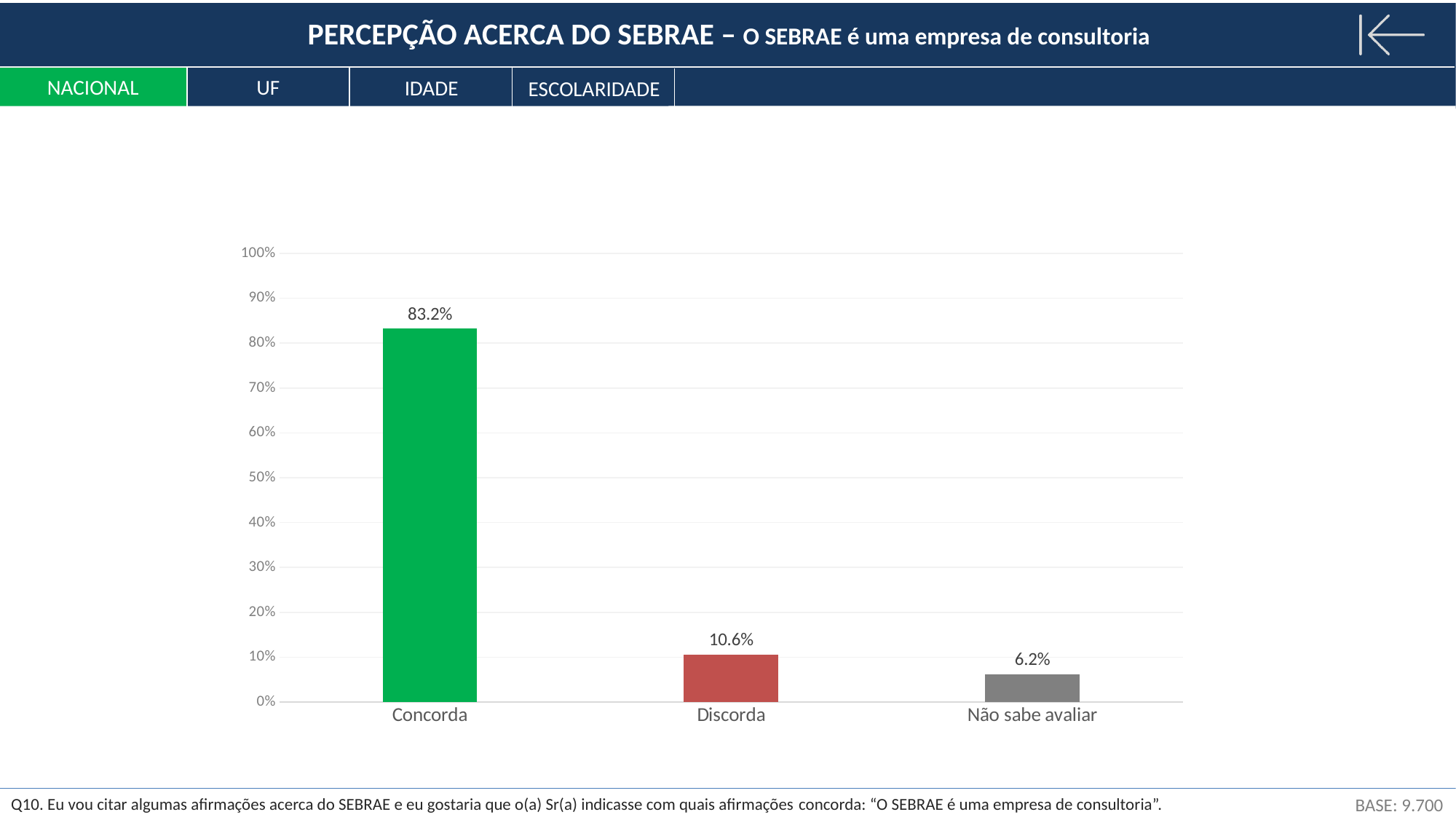
Which is larger, the value for Discorda or the value for Não sabe avaliar? Discorda Is the value for Concorda greater or less than 80%? greater What is the value for Não sabe avaliar? 6.2% What is the difference between the values for Concorda and Discorda? 72.6% What is the value for Concorda? 83.2% Which category has the lowest value? Não sabe avaliar Which category has the highest value? Concorda What is the difference between the values for Discorda and Não sabe avaliar? 4.4% What colour is the bar for Discorda? red What is the value for Discorda? 10.6% How many categories are shown on the x axis? 3 What kind of chart is shown on the slide? bar chart